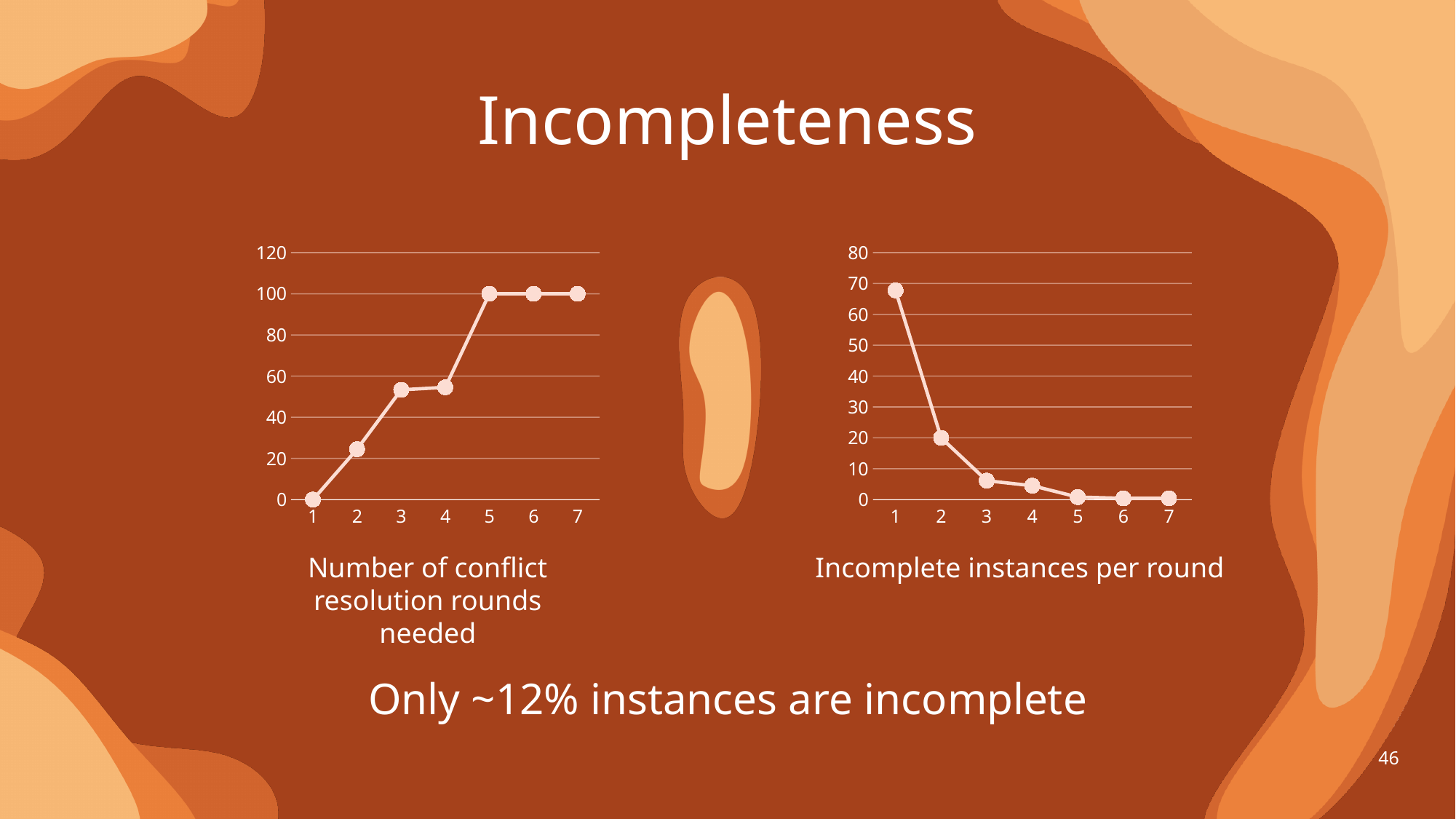
How many points are plotted on the left chart, 'Number of conflict resolution rounds needed'? 7 In the right chart, 'Incomplete instances per round', which is larger, the value at x = 2 or the value at x = 3? x = 2 In the left chart, 'Number of conflict resolution rounds needed', is the value at x = 3 greater or less than 40? greater In the right chart, 'Incomplete instances per round', do the values rise or fall as x increases? fall In the right chart, 'Incomplete instances per round', is the value at x = 1 greater or less than 60? greater In the left chart, 'Number of conflict resolution rounds needed', do the values rise or fall as x increases from 1 to 5? rise How many points are plotted on the right chart, 'Incomplete instances per round'? 7 In the left chart, 'Number of conflict resolution rounds needed', what is the value at x = 1? 0 What kind of chart is the left chart, 'Number of conflict resolution rounds needed'? line chart What kind of chart is the right chart, 'Incomplete instances per round'? line chart In the right chart, 'Incomplete instances per round', which x value has the highest value? 1 In the left chart, 'Number of conflict resolution rounds needed', what is the value at x = 5? 100